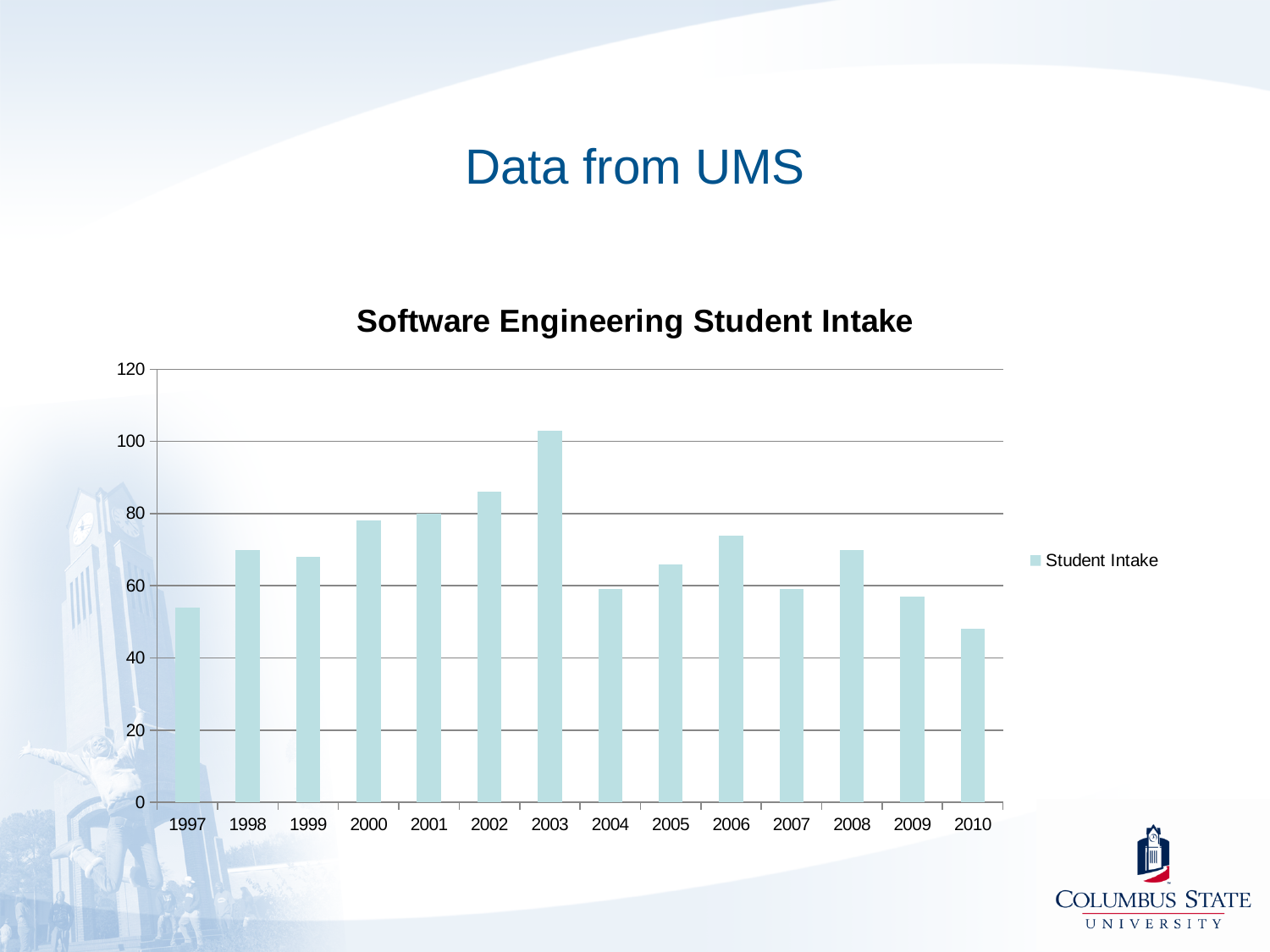
What kind of chart is shown on the slide? bar chart Is the value for 2010 greater or less than 60? less Which is larger, the student intake in 2002 or in 2005? 2002 Is the value for 2003 greater or less than 100? greater Is the value for 2002 greater or less than 80? greater Which year has the lowest student intake? 2010 How many series does the legend list? 1 Between 2008 and 2010, do the values rise or fall? fall What is the name of the series shown in the legend? Student Intake What is the title of the chart? Software Engineering Student Intake How many years are shown on the x axis? 14 Which year has the highest student intake? 2003